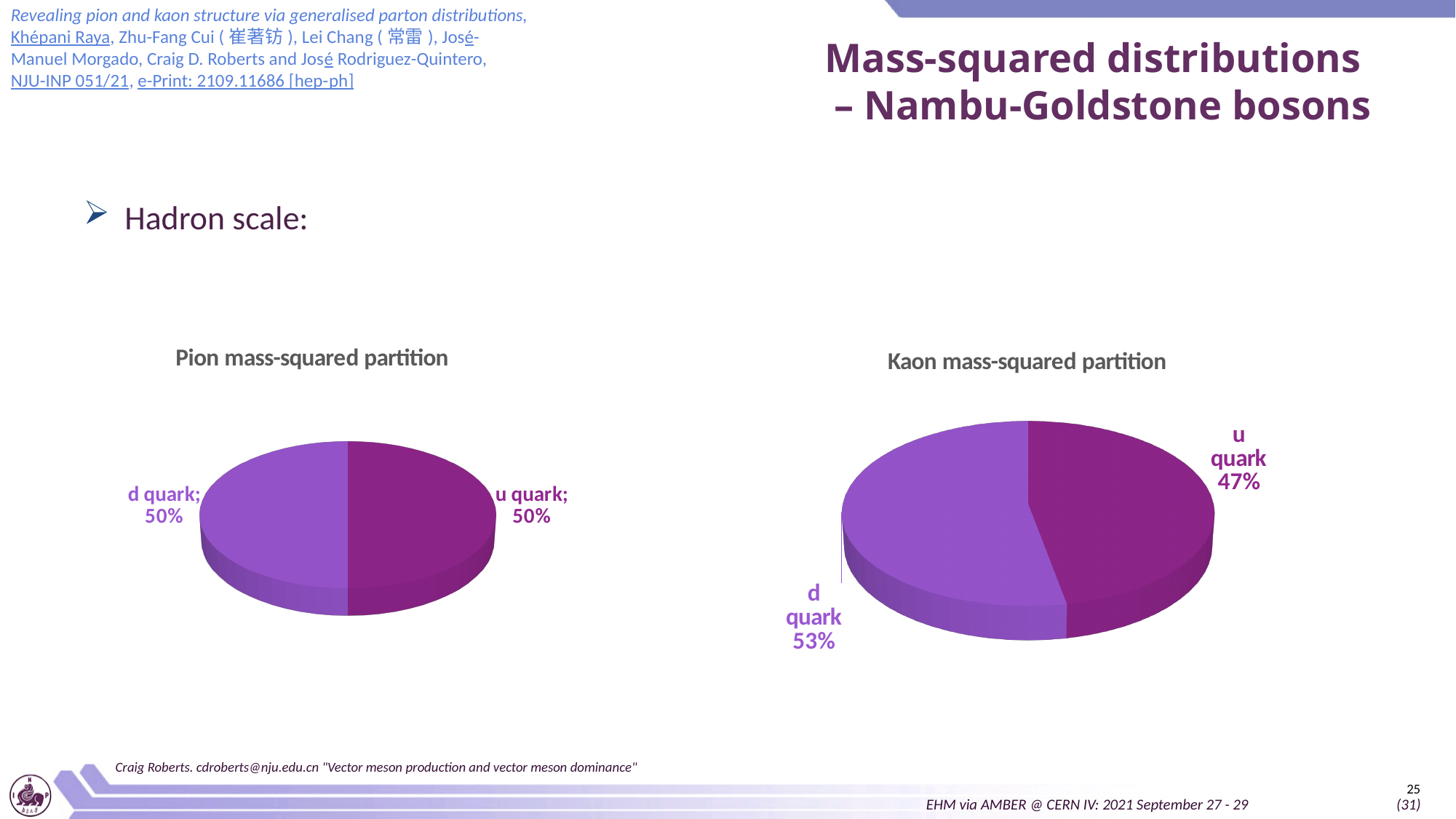
In the 'Kaon mass-squared partition' chart, what is the difference between the d quark and u quark shares? 6% In the 'Kaon mass-squared partition' chart, which quark has the larger share? d quark How many pie charts are shown on the slide? 2 In the 'Kaon mass-squared partition' chart, which quark has the smaller share? u quark What kind of chart is the 'Pion mass-squared partition' chart? Pie chart How many slices does the 'Kaon mass-squared partition' chart have? 2 In the 'Kaon mass-squared partition' chart, what share does the d quark have? 53% In the 'Kaon mass-squared partition' chart, is the u quark share greater or less than 50%? less What is the title of the chart on the left side of the slide? Pion mass-squared partition In the 'Pion mass-squared partition' chart, what share does the d quark have? 50% In the 'Pion mass-squared partition' chart, what share does the u quark have? 50% In the 'Kaon mass-squared partition' chart, what share does the u quark have? 47%